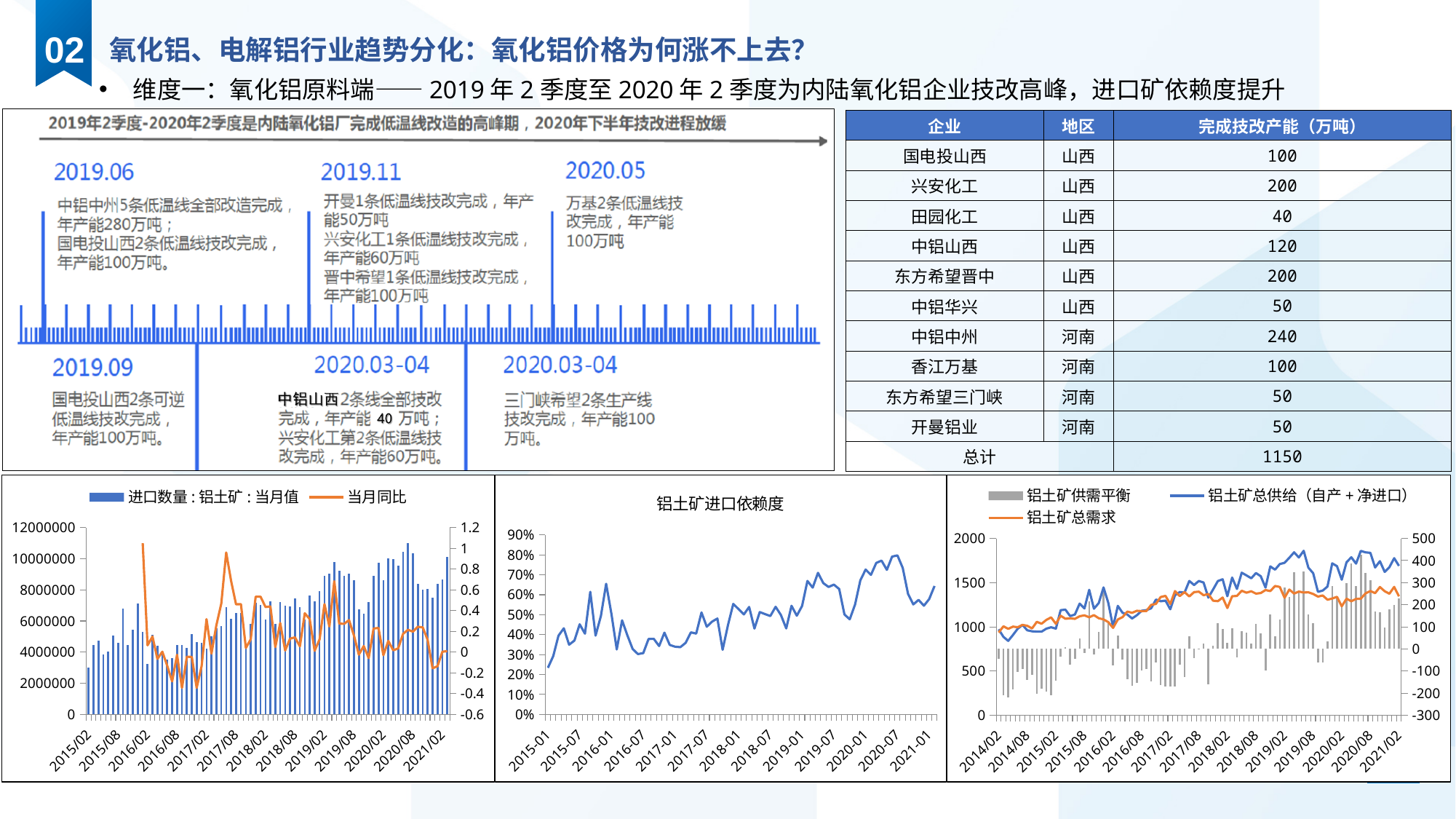
In the rightmost bottom chart, is the '铝土矿总供给（自产+净进口）' value at 2014/02 greater or less than 1500? less In the chart '铝土矿进口依赖度', does the line generally rise or fall from 2015-01 to 2021-01? rise In the rightmost bottom chart, at 2021/02 which is larger, '铝土矿总供给（自产+净进口）' or '铝土矿总需求'? 铝土矿总供给（自产+净进口） What is the title of the middle chart at the bottom of the slide? 铝土矿进口依赖度 In the leftmost bottom chart, do the import quantity bars generally rise or fall from 2015/02 to 2021/02? rise How many series does the legend of the leftmost bottom chart list? 2 In the chart '铝土矿进口依赖度', is the value around 2020-07 greater or less than 70%? greater In the chart '铝土矿进口依赖度', is the value at 2015-01 greater or less than 30%? less What kind of chart is the leftmost chart at the bottom of the slide (legend '进口数量:铝土矿:当月值' and '当月同比')? Combined bar and line chart How many series does the legend of the rightmost bottom chart (with '铝土矿供需平衡') list? 3 What kind of chart is the middle bottom chart titled '铝土矿进口依赖度'? Line chart